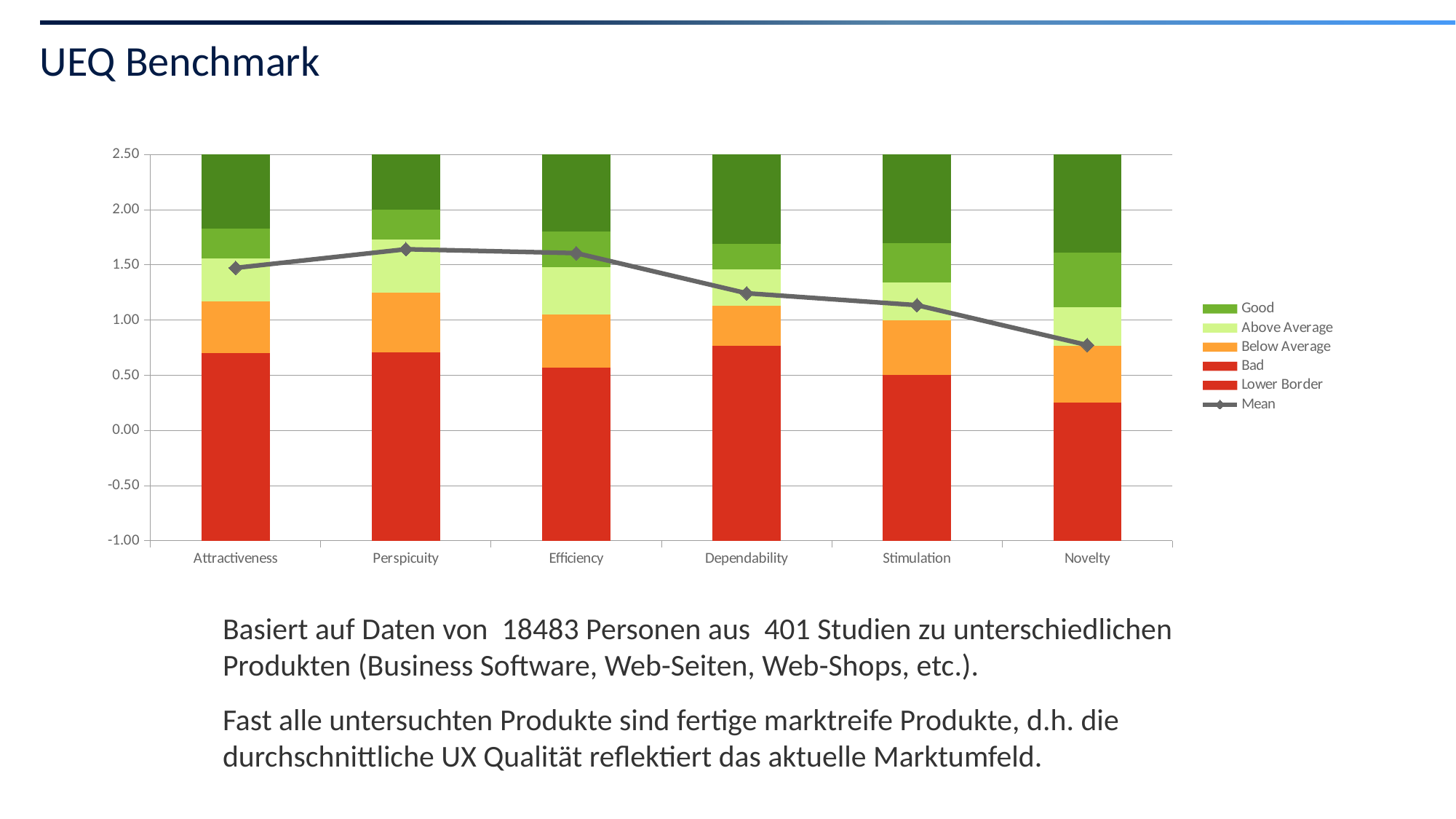
Does the Mean line rise or fall from Efficiency to Novelty? Fall What is the title of the slide containing the chart? UEQ Benchmark Which category has the lowest Mean value? Novelty Is the Mean value for Novelty greater or less than 1.00? less How many categories are shown on the x axis of the chart? 6 Is the Mean value for Dependability greater or less than 1.00? greater What kind of chart is shown on the slide? Stacked bar chart with a line How many series does the chart's legend list? 6 Is the Mean value for Perspicuity greater or less than 1.50? greater Which legend entry is shown in dark green? Good Which has the larger Mean value, Perspicuity or Novelty? Perspicuity